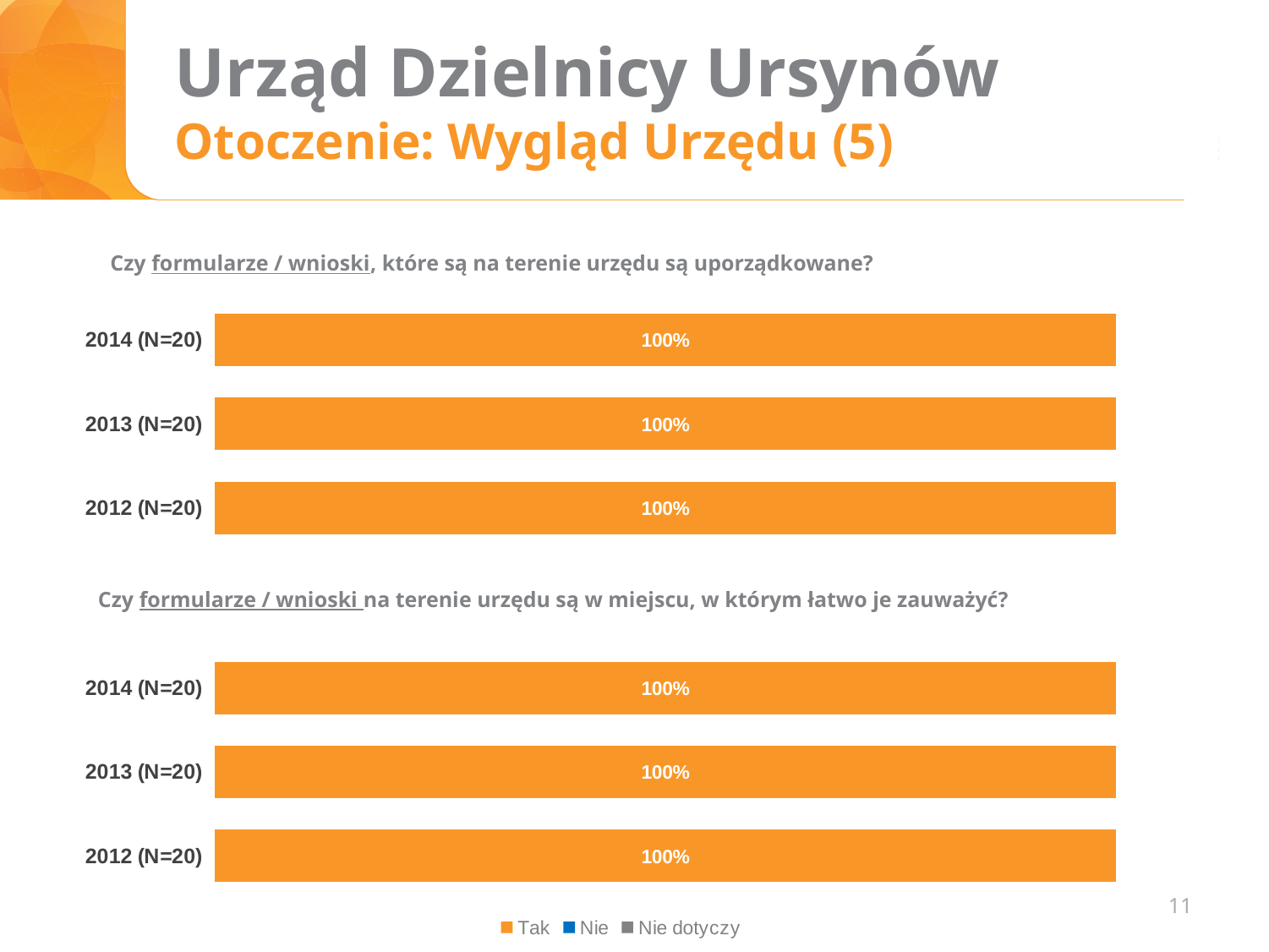
In the top chart ("Czy formularze / wnioski, które są na terenie urzędu są uporządkowane?"), what is the value for 2012 (N=20)? 100% In the top chart, what is the difference between the values for 2014 (N=20) and 2012 (N=20)? 0% In the bottom chart ("Czy formularze / wnioski na terenie urzędu są w miejscu, w którym łatwo je zauważyć?"), what is the value for 2013 (N=20)? 100% In the bottom chart ("Czy formularze / wnioski na terenie urzędu są w miejscu, w którym łatwo je zauważyć?"), what is the value for 2014 (N=20)? 100% How many categories (years) are shown in the top chart? 3 How many series does the legend at the bottom of the slide list? 3 Which legend entry is shown in orange? Tak What kind of chart is the top chart? Bar chart How many categories (years) are shown in the bottom chart? 3 What is the sample size (N) shown for each year in the bottom chart? N=20 In the top chart ("Czy formularze / wnioski, które są na terenie urzędu są uporządkowane?"), what is the value for 2014 (N=20)? 100% In the bottom chart, do the values change between 2012 (N=20) and 2014 (N=20)? No, they stay at 100%